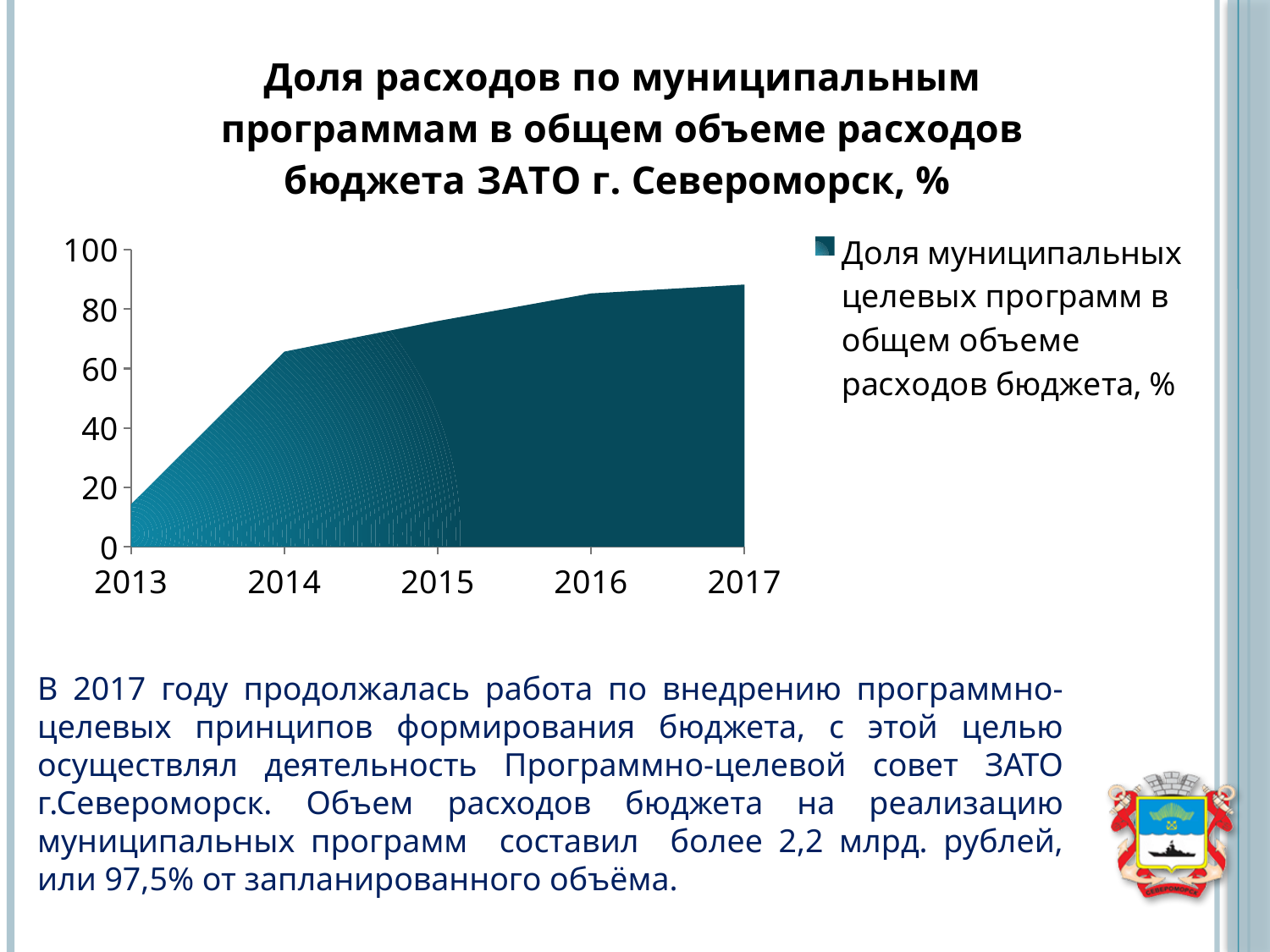
What is the legend entry of the chart? Доля муниципальных целевых программ в общем объеме расходов бюджета, % How many years are shown on the x axis of the chart? 5 Which year has the larger value, 2013 or 2014? 2014 Which year has the highest share of municipal programme expenditure? 2017 Do the values rise or fall from 2013 to 2017? Rise Is the value for 2015 greater or less than 80? less Is the value for 2014 greater or less than 60? greater Is the value for 2016 greater or less than 80? greater Which year has the lowest share of municipal programme expenditure? 2013 How many series does the chart legend list? 1 What kind of chart is shown on the slide? Area chart